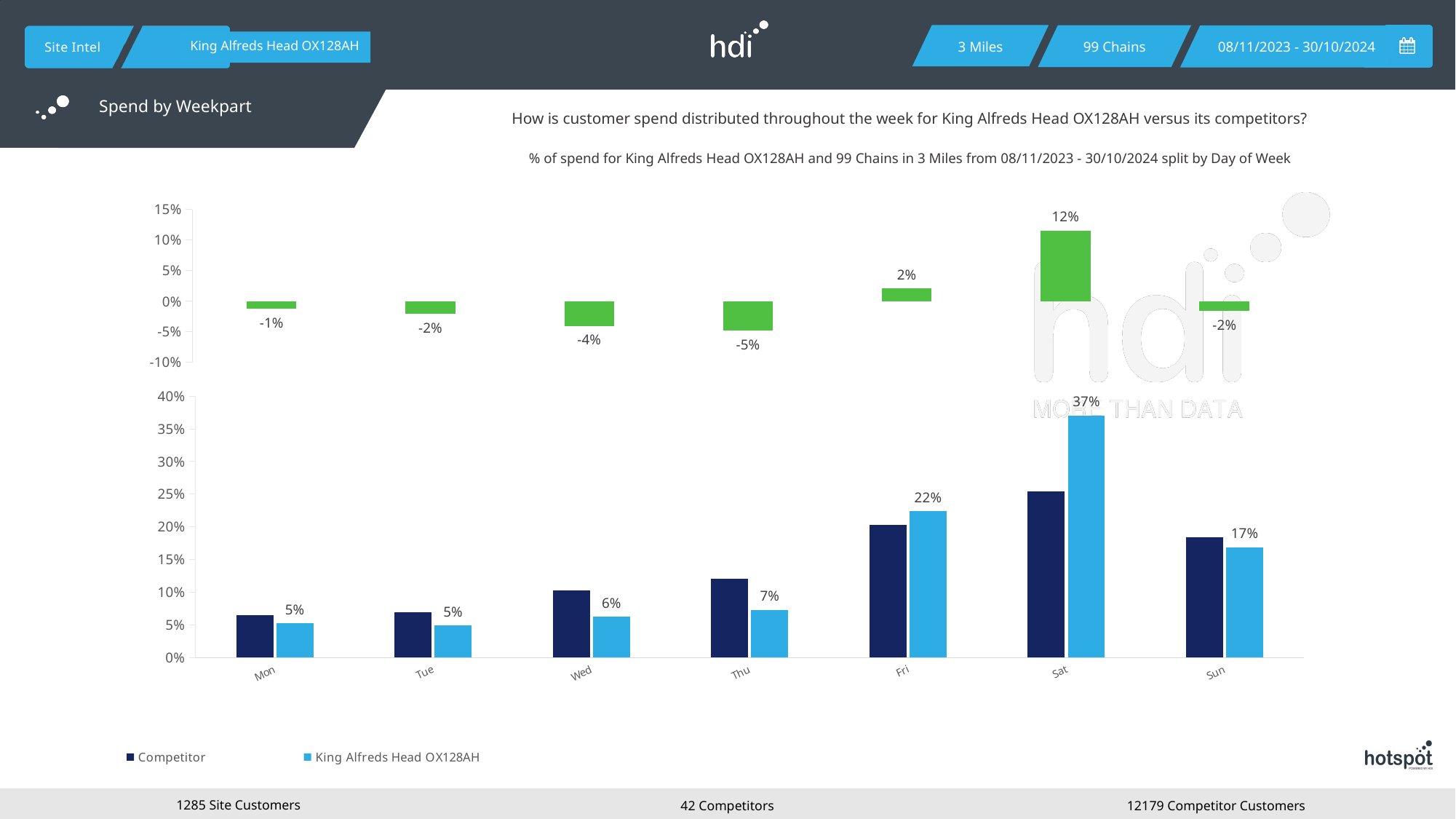
How many days of the week are shown on the x axis of the bottom chart? 7 In the top chart, which day has the lowest value? Thu In the bottom chart, which is larger on Thu: the Competitor value or the King Alfreds Head OX128AH value? Competitor In the bottom chart, is the Competitor value for Sat greater or less than 20%? greater In the bottom chart, what is the difference between the King Alfreds Head OX128AH values for Sat and Fri? 15% In the top chart, what is the value shown for Sat? 12% In the bottom chart, what is the value for King Alfreds Head OX128AH on Fri? 22% In the bottom chart, what is the value for King Alfreds Head OX128AH on Sat? 37% How many series does the legend of the bottom chart list? 2 In the top chart, what is the value shown for Thu? -5% In the bottom chart, is the Competitor value for Mon greater or less than 10%? less In the bottom chart, which day has the highest value for King Alfreds Head OX128AH? Sat